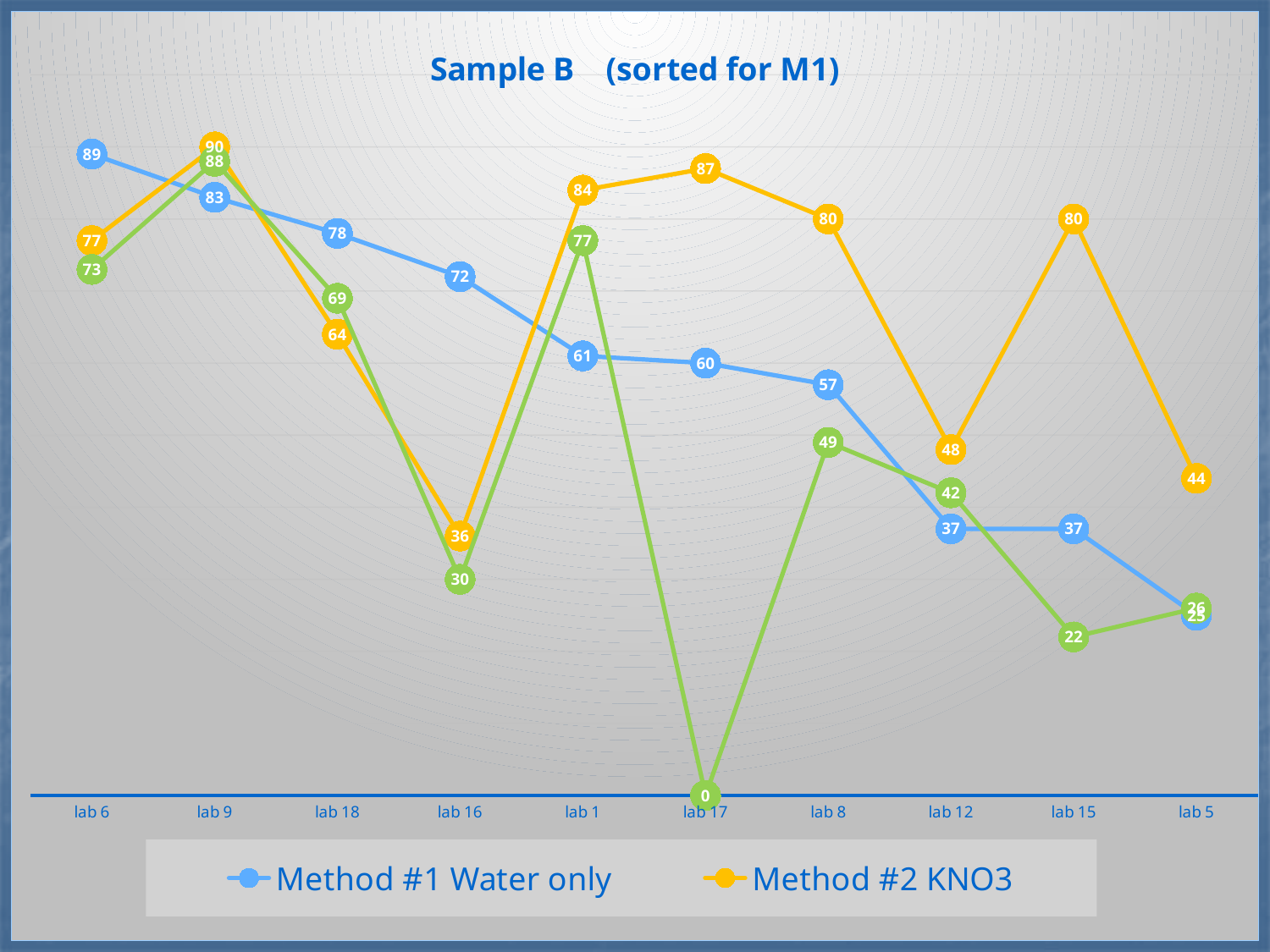
At lab 12, which series has the higher value, Method #1 Water only or Method #2 KNO3? Method #2 KNO3 At lab 1, what is the difference between Method #2 KNO3 and Method #1 Water only? 23 What kind of chart is shown on the slide? line chart How many series does the legend list? 2 What is the value for Method #1 Water only at lab 8? 57 What is the title of the chart? Sample B (sorted for M1) Does the Method #1 Water only line rise or fall from lab 6 to lab 5 along the x axis? fall What is the value for Method #1 Water only at lab 18? 78 At which lab does Method #2 KNO3 reach its highest value? lab 9 What is the value for Method #2 KNO3 at lab 17? 87 At which lab does Method #2 KNO3 have its lowest value? lab 16 How many lab categories are shown on the x axis? 10